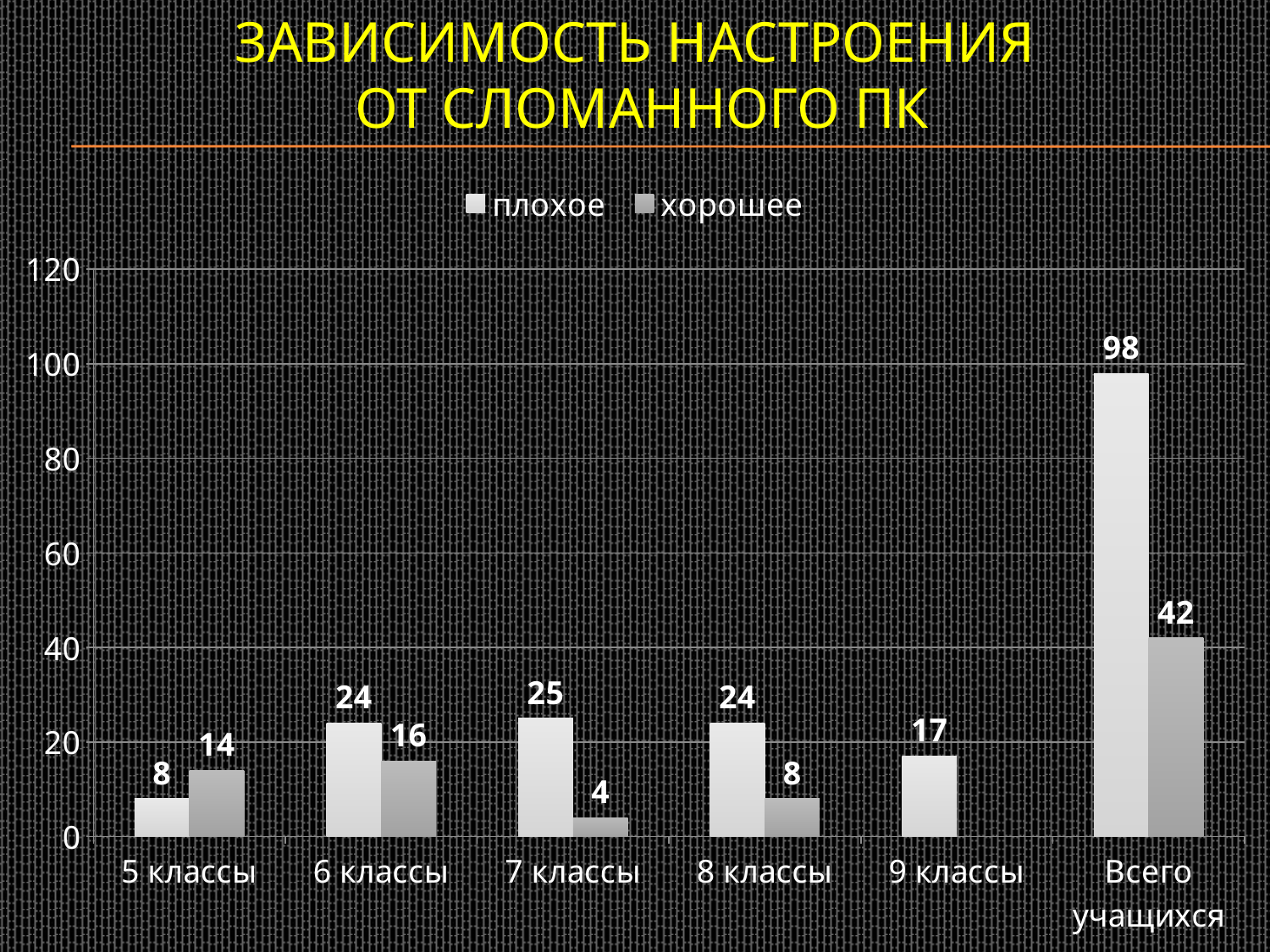
How many categories are shown on the x axis? 6 What is the value of "плохое" for "Всего учащихся"? 98 Which is larger for "5 классы": "плохое" or "хорошее"? хорошее What is the value of "плохое" for "7 классы"? 25 What is the value of "хорошее" for "8 классы"? 8 What type of chart is shown on the slide? bar chart Which category has the highest value for "плохое"? Всего учащихся Which category has the lowest value for "хорошее" among those with a labelled bar? 7 классы How many series does the legend list? 2 What is the difference between "плохое" and "хорошее" for "Всего учащихся"? 56 What is the value of "хорошее" for "5 классы"? 14 What is the difference between "плохое" for "6 классы" and "плохое" for "9 классы"? 7